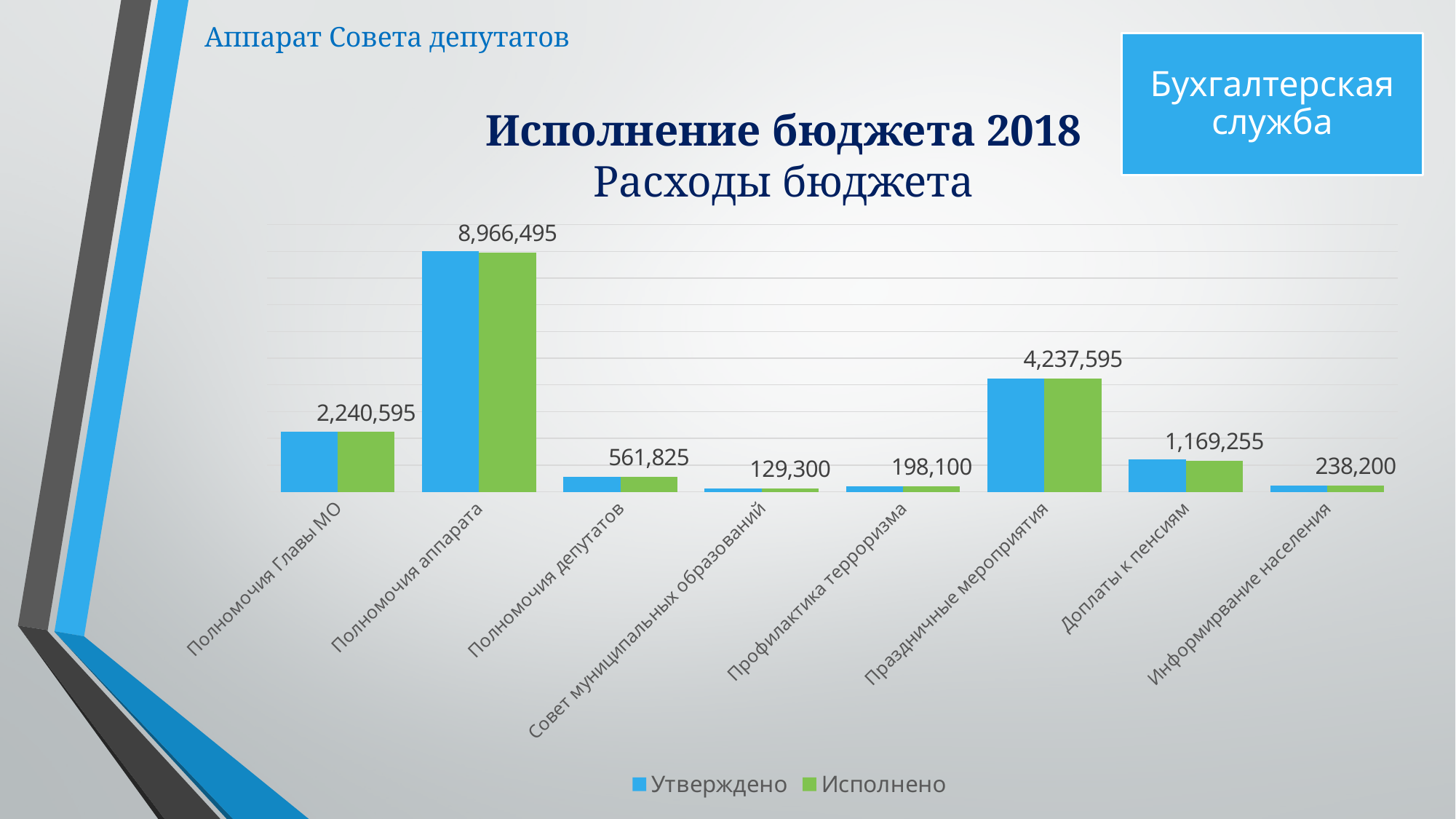
How many categories are shown on the x axis of the chart? 8 Which category has the lowest labelled value in the chart? Совет муниципальных образований What value is labelled above the bars for Совет муниципальных образований? 129,300 What kind of chart is shown on the slide? Bar chart What value is labelled above the bars for Полномочия аппарата? 8,966,495 What are the two series named in the chart legend? Утверждено and Исполнено How many series does the chart legend list? 2 What value is labelled above the bars for Праздничные мероприятия? 4,237,595 What is the difference between the labelled values for Информирование населения and Профилактика терроризма? 40,100 Which category has the larger labelled value: Полномочия Главы МО or Полномочия депутатов? Полномочия Главы МО What value is labelled above the bars for Доплаты к пенсиям? 1,169,255 Which category has the highest labelled value in the chart? Полномочия аппарата